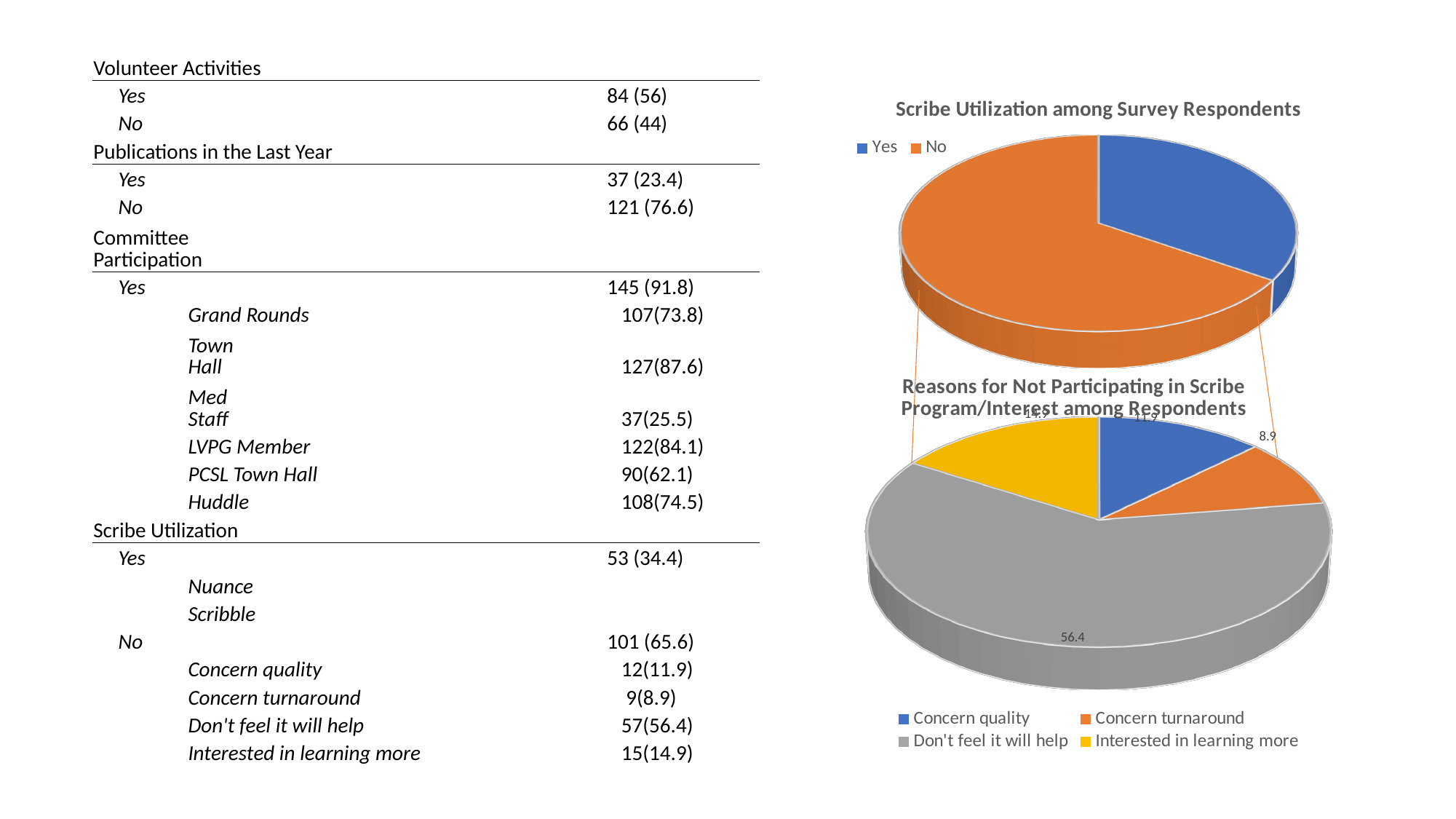
How many entries does the legend of 'Scribe Utilization among Survey Respondents' list? 2 How many slices does the 'Reasons for Not Participating in Scribe Program/Interest among Respondents' chart have? 4 In 'Reasons for Not Participating in Scribe Program/Interest among Respondents', which category has the largest slice? Don't feel it will help In 'Reasons for Not Participating in Scribe Program/Interest among Respondents', what colour is the 'Don't feel it will help' slice? gray In 'Scribe Utilization among Survey Respondents', which category has the largest slice? No In 'Reasons for Not Participating in Scribe Program/Interest among Respondents', which category has the smallest slice? Concern turnaround What kind of chart is 'Reasons for Not Participating in Scribe Program/Interest among Respondents'? pie chart In 'Reasons for Not Participating in Scribe Program/Interest among Respondents', what is the value for 'Concern turnaround'? 8.9 What kind of chart is 'Scribe Utilization among Survey Respondents'? pie chart In 'Reasons for Not Participating in Scribe Program/Interest among Respondents', what is the difference between the values for 'Don't feel it will help' and 'Concern turnaround'? 47.5 In 'Scribe Utilization among Survey Respondents', which slice is larger, Yes or No? No In 'Reasons for Not Participating in Scribe Program/Interest among Respondents', what is the value for 'Don't feel it will help'? 56.4